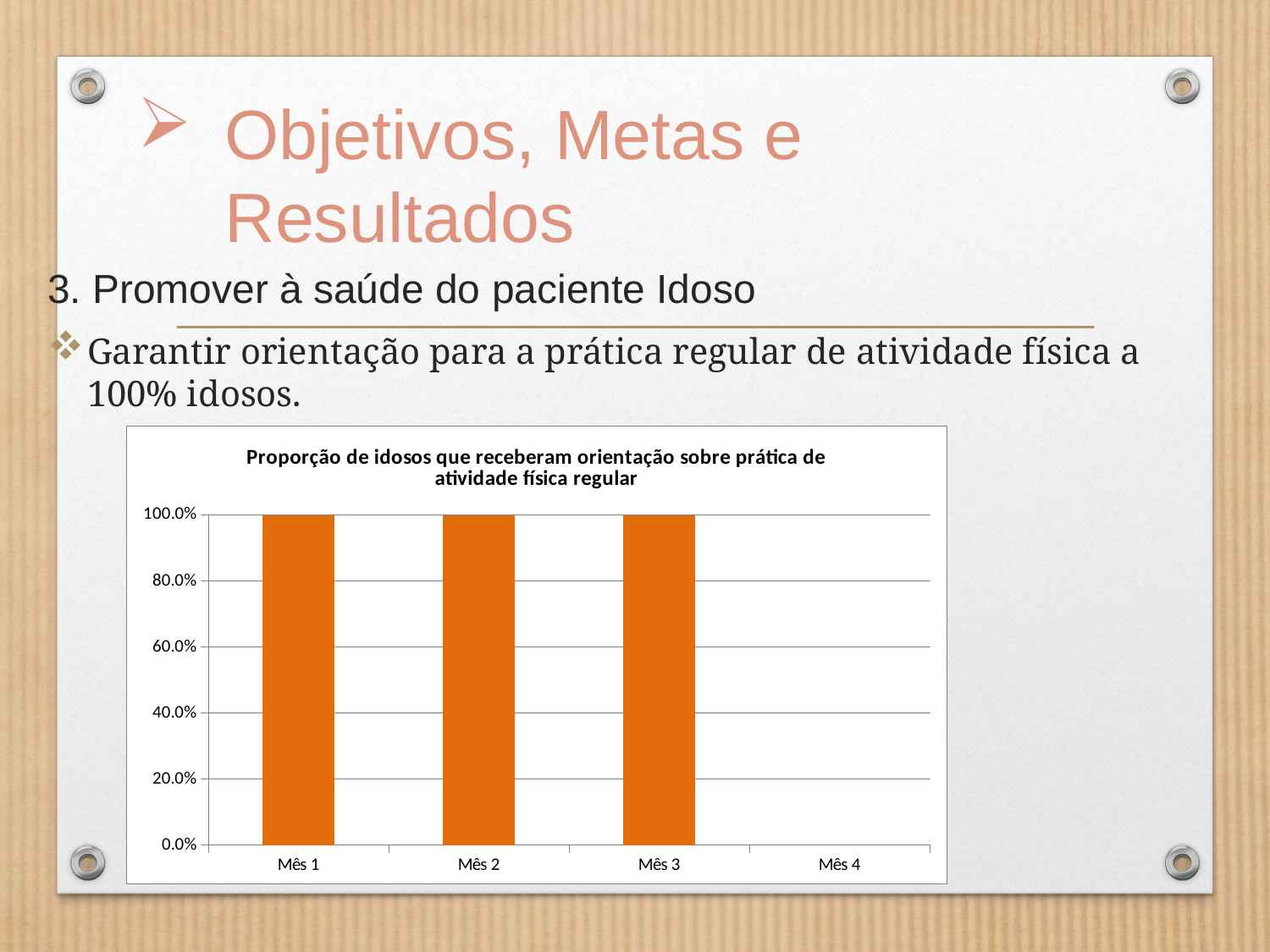
How many categories are shown on the x axis of the chart? 4 What is the value for Mês 1 in the chart? 100.0% Which has the larger value, Mês 1 or Mês 4? Mês 1 What is the title of the chart? Proporção de idosos que receberam orientação sobre prática de atividade física regular Do the values rise, fall or stay the same from Mês 1 to Mês 3? stay the same Is the value for Mês 4 greater or less than 20.0%? less What kind of chart is shown on the slide? bar chart What colour are the bars in the chart? orange What is the difference between the values for Mês 1 and Mês 3? 0.0% Is the value for Mês 2 greater or less than 80.0%? greater What is the value for Mês 2 in the chart? 100.0% What is the value for Mês 3 in the chart? 100.0%